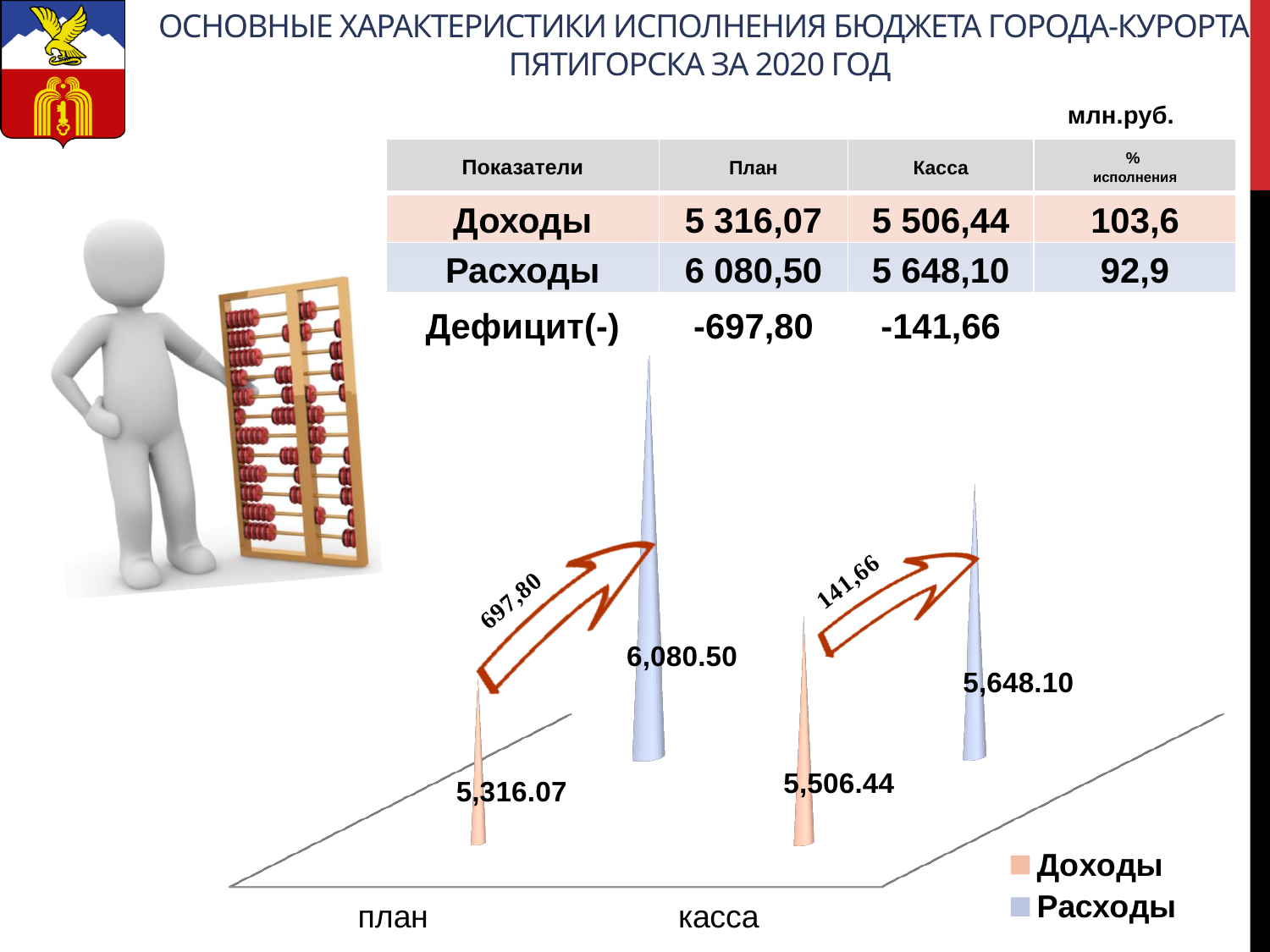
How many categories are shown on the x axis of the chart? 2 What is the difference between Расходы and Доходы for план in the chart? 764.43 What is the value of Доходы for касса in the chart? 5,506.44 What is the value of Расходы for план in the chart? 6,080.50 What are the two series named in the chart legend? Доходы and Расходы Which is larger in the chart: Доходы for план or Доходы for касса? Доходы for касса What is the difference between Расходы and Доходы for касса in the chart? 141.66 Which bar in the chart has the lowest value? Доходы, план How many series does the chart legend list? 2 What is the value of Расходы for касса in the chart? 5,648.10 Which bar in the chart has the highest value? Расходы, план What is the value of Доходы for план in the chart? 5,316.07